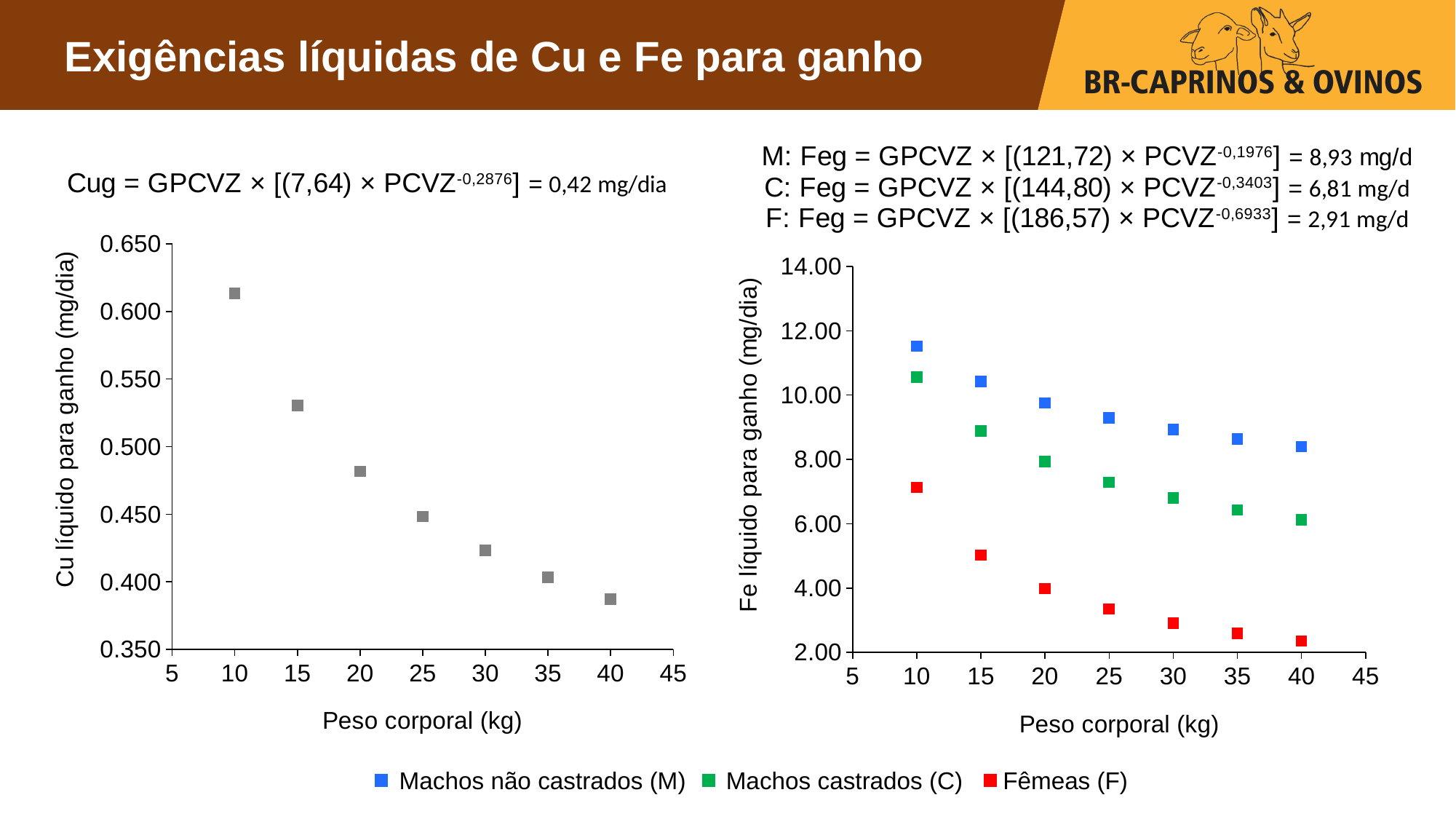
In the left chart (Cu líquido para ganho), how many data points are plotted? 7 In the right chart (Fe líquido para ganho), which series has the highest value at 10 kg? Machos não castrados (M) In the right chart (Fe líquido para ganho), is the value for Machos não castrados (M) at 10 kg greater or less than 10.00? greater In the right chart (Fe líquido para ganho), which is larger at 25 kg: Machos castrados (C) or Fêmeas (F)? Machos castrados (C) In the right chart (Fe líquido para ganho), which series has the lowest value at 40 kg? Fêmeas (F) In the left chart (Cu líquido para ganho), is the value at 10 kg greater or less than 0.600? greater In the left chart (Cu líquido para ganho), do the values rise or fall as body weight (Peso corporal) increases? fall In the left chart (Cu líquido para ganho), is the value at 40 kg greater or less than 0.400? less What kind of chart is the left chart (Cu líquido para ganho)? scatter chart In the right chart (Fe líquido para ganho), how many series does the legend list? 3